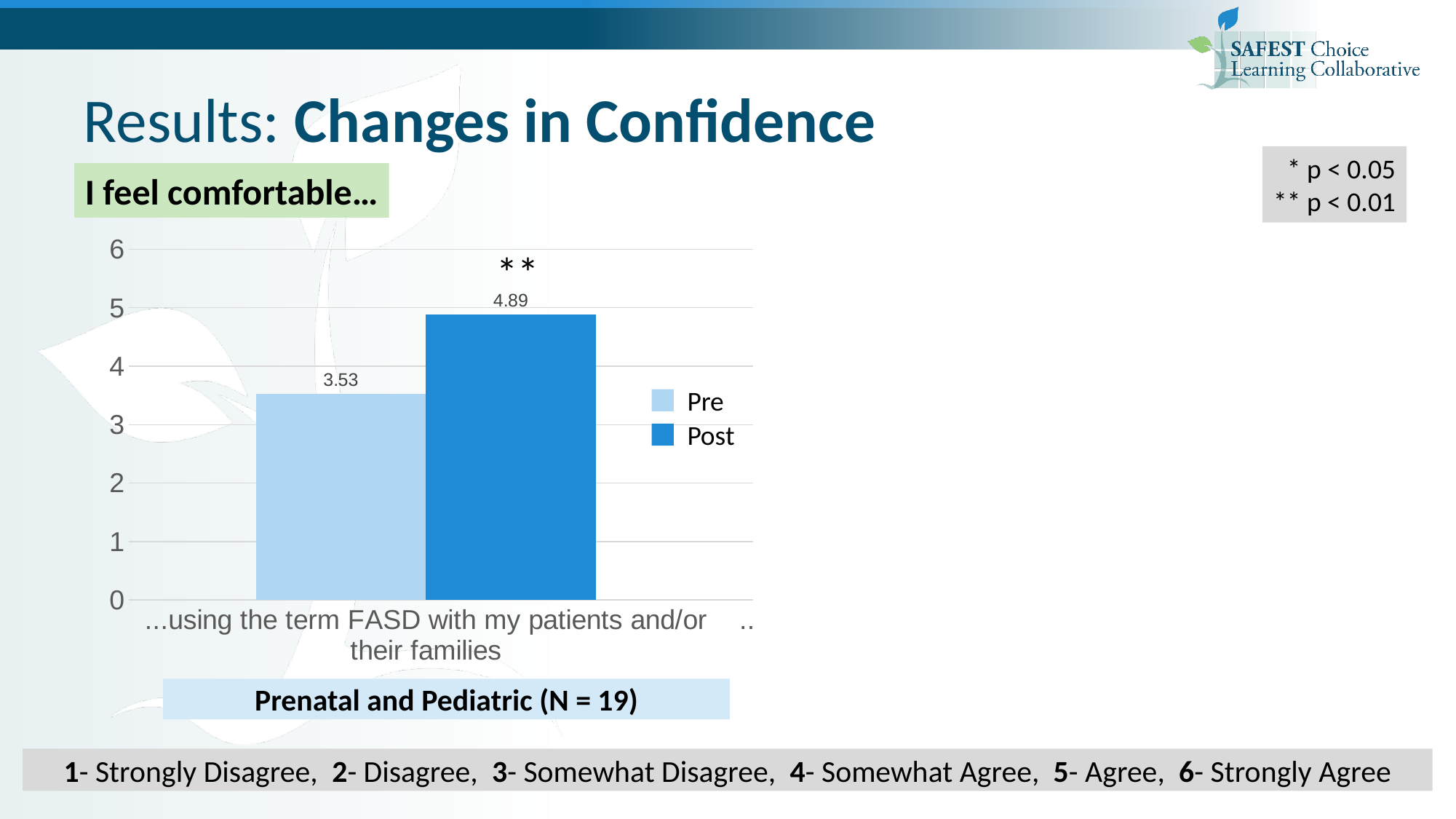
What is the Pre value for "...using the term FASD with my patients and/or their families"? 3.53 Is the Post value greater or less than 4? greater What is the difference between the Post and Pre values? 1.36 Which series is shown in the darker blue colour? Post What is the sample size (N) stated below the chart? 19 What are the two legend entries of the chart? Pre, Post What is the Post value for "...using the term FASD with my patients and/or their families"? 4.89 What is the maximum value shown on the y axis? 6 How many series does the legend list? 2 Is the Pre value greater or less than 4? less Which series has the higher value, Pre or Post? Post What kind of chart is shown on the slide? bar chart